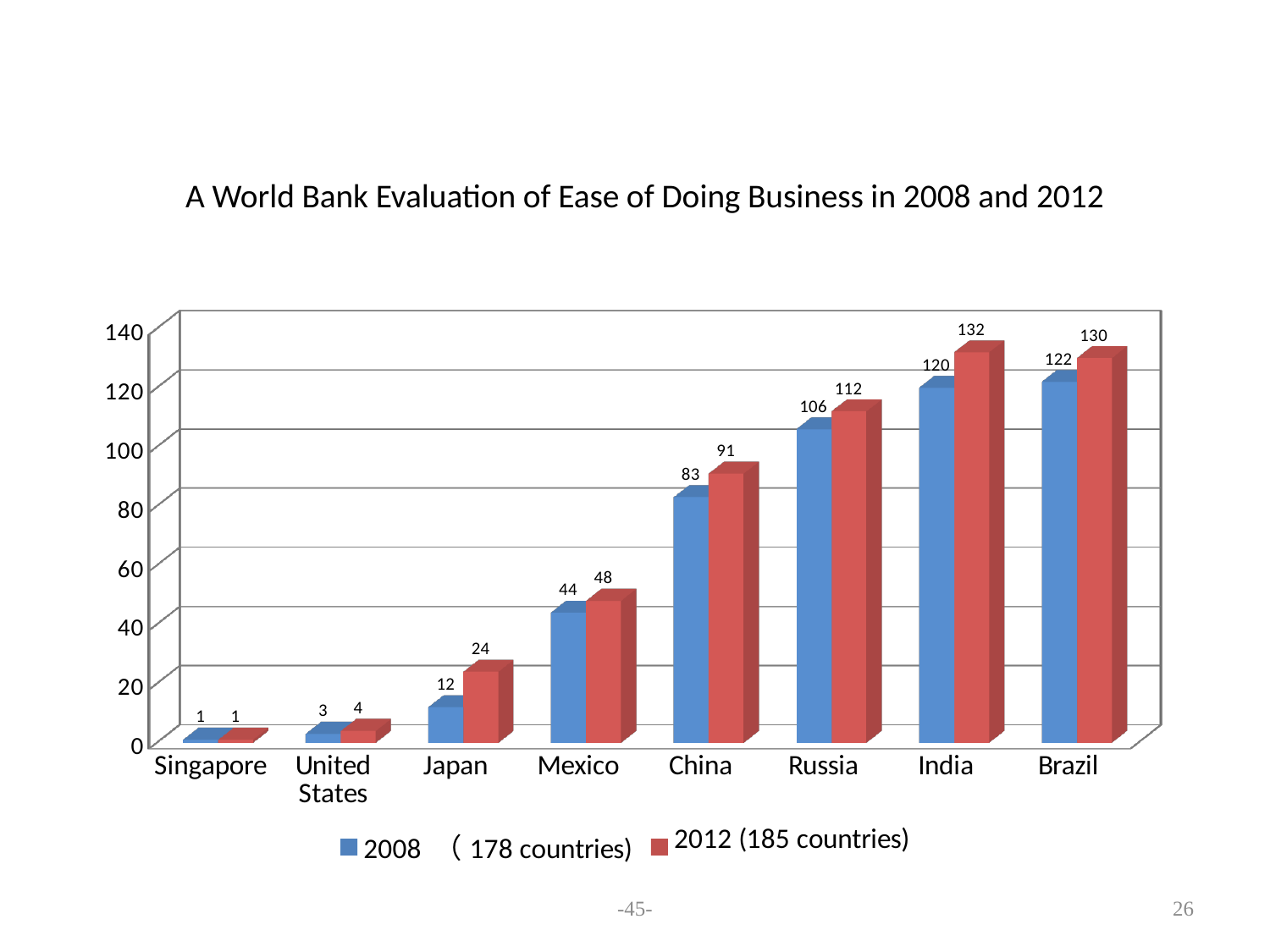
How many countries are shown on the x axis? 8 What kind of chart is shown on the slide? Bar chart Which country has the lowest 2008 value? Singapore Which is larger, the 2008 value for Brazil or the 2008 value for India? Brazil What is the difference between the 2012 and 2008 values for Japan? 12 Do the 2012 values rise or fall from Singapore to India along the x axis? Rise Which country has the highest 2012 value? India How many series does the legend list? 2 What is the difference between the 2012 values for India and Russia? 20 What is the 2012 value for China? 91 What is the 2008 value for Japan? 12 What is the 2012 value for Brazil? 130